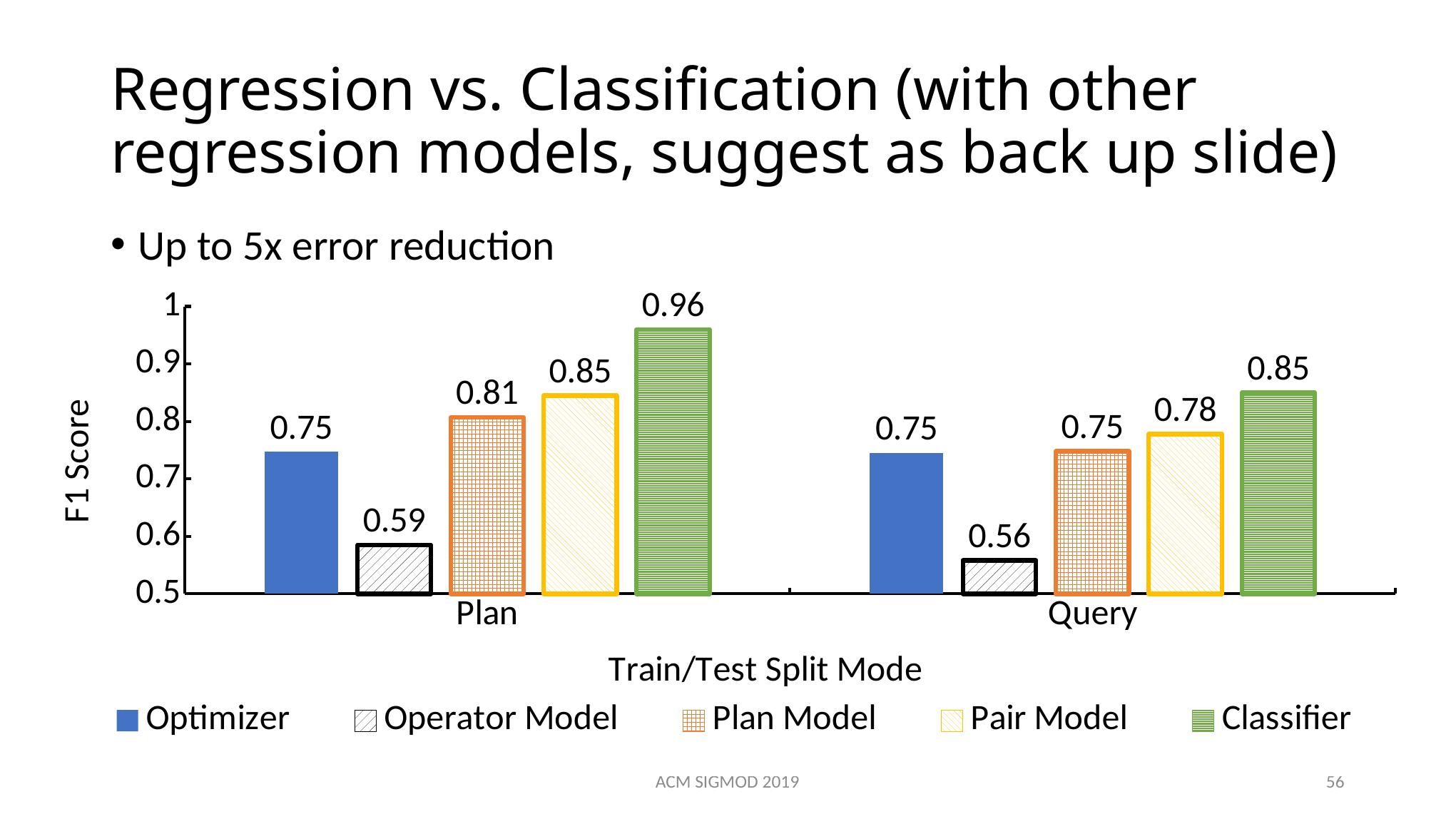
What is the label of the y axis? F1 Score What is the label of the x axis? Train/Test Split Mode How many series does the legend list? 5 How many train/test split modes are shown on the x axis? 2 Which series has the lowest F1 Score in the Plan split mode? Operator Model What is the F1 Score of the Operator Model in the Query split mode? 0.56 What is the difference between the Classifier and Optimizer F1 Scores in the Plan split mode? 0.21 What kind of chart is shown on the slide? Bar chart What is the F1 Score of the Classifier in the Plan split mode? 0.96 What is the F1 Score of the Pair Model in the Plan split mode? 0.85 Which series has the highest F1 Score in the Query split mode? Classifier Which is larger: the Plan Model F1 Score in Plan mode or the Plan Model F1 Score in Query mode? Plan Model in Plan mode